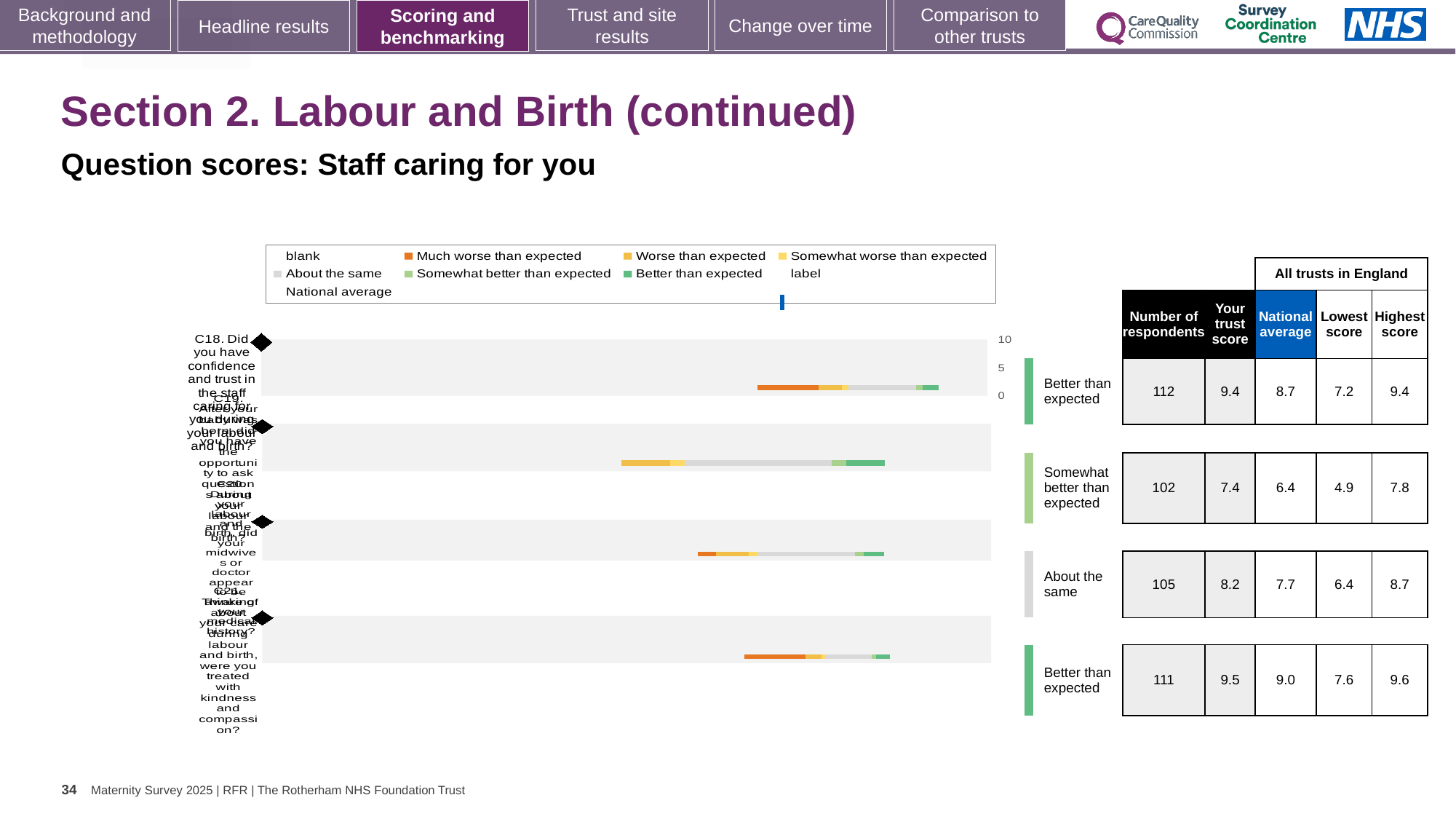
What is the difference between the trust score and the national average for the first question, C18? 0.7 What is the national average for the second question, C19? 6.4 What is the highest score across all trusts in England for the last question, C21? 9.6 Which question has the highest trust score? C21 What is the number of respondents for the first question, C18? 112 How many questions (categories) are plotted on the chart? 4 What kind of chart is shown on the slide? bar chart What colour represents 'Much worse than expected' in the chart legend? orange Which question has the lowest trust score? C19 What is the trust score for the first question, C18? 9.4 For the second question, C19, which is larger: the trust score or the national average? the trust score Is the trust score for the third question, C20, greater or less than 5? greater